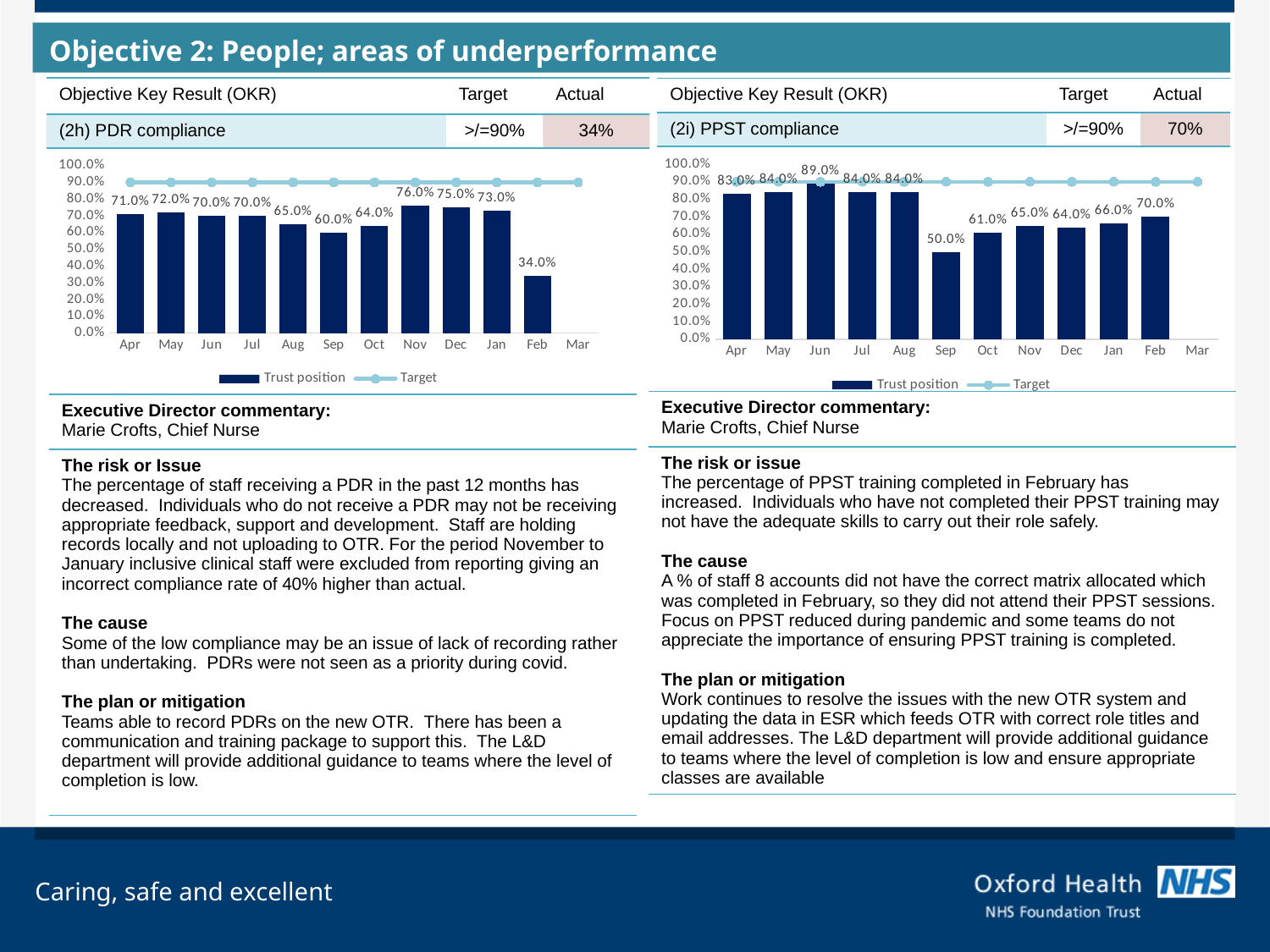
In the right chart (PPST compliance), what is the Trust position value for Sep? 50.0% In the left chart (PDR compliance), which month has the highest Trust position bar? Nov In the right chart (PPST compliance), which month has the lowest Trust position bar? Sep In the left chart (PDR compliance), what type of chart is used for the Trust position series? Bar chart In the left chart (PDR compliance), what is the Trust position value for Feb? 34.0% In the right chart (PPST compliance), is the Target line value greater or less than 80.0%? greater In the right chart (PPST compliance), which month has the highest Trust position bar? Jun In the left chart (PDR compliance), which month has the lowest Trust position bar? Feb In the right chart (PPST compliance), what is the difference between the Trust position values for Jun and Sep? 39.0% In the right chart (PPST compliance), is the Trust position value for Jun larger or smaller than the value for Feb? Larger In the left chart (PDR compliance), how many series does the legend list? 2 In the left chart (PDR compliance), what is the difference between the Trust position values for Nov and Sep? 16.0%